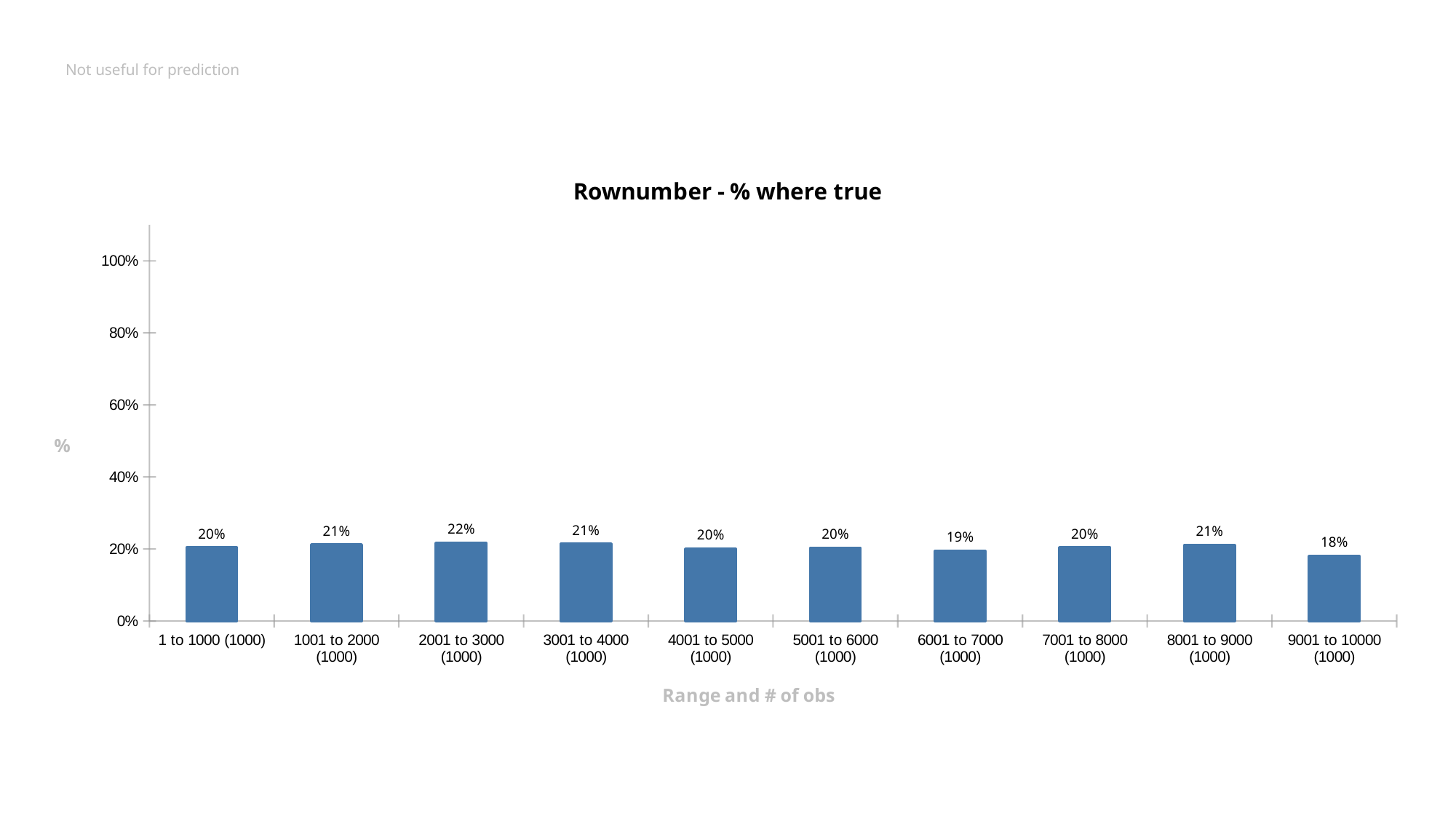
Which is larger, the value for 1001 to 2000 (1000) or the value for 6001 to 7000 (1000)? 1001 to 2000 (1000) What is the title of the chart? Rownumber - % where true What is the value for the 2001 to 3000 (1000) range? 22% Which range has the lowest value? 9001 to 10000 (1000) How many ranges are shown on the x axis? 10 What is the value for the 9001 to 10000 (1000) range? 18% What kind of chart is shown on the slide? bar chart What is the difference between the values for 2001 to 3000 (1000) and 9001 to 10000 (1000)? 4% What is the value for the 6001 to 7000 (1000) range? 19% What is the label of the x axis? Range and # of obs Which range has the highest value? 2001 to 3000 (1000) Is the value for 3001 to 4000 (1000) greater or less than 40%? less